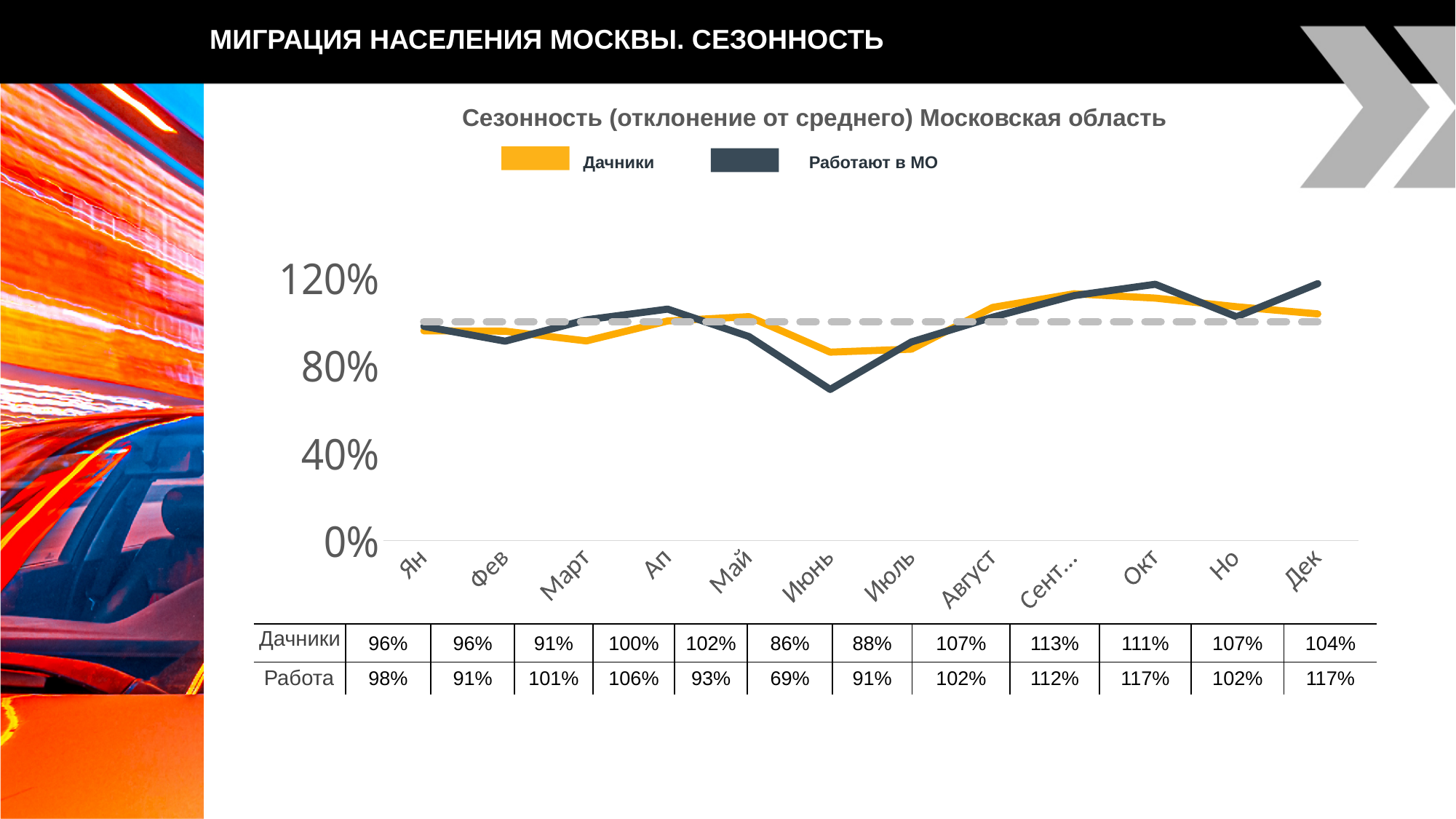
What is the value for Работа in Окт? 117% What is the value for Дачники in Июнь? 86% What is the difference between the Дачники and Работа values in Июнь? 17 percentage points How many months are plotted along the x axis? 12 Do the Дачники values rise or fall from Июнь to Сент...? rise How many series does the legend list? 2 In Май, which series has the larger value, Дачники or Работа? Дачники In which month is the Работа series at its lowest? Июнь In which month does the Работа series reach its highest value of 117% for the first time? Окт What is the title of the chart? Сезонность (отклонение от среднего) Московская область What kind of chart is shown on the slide? line chart Is the value for Работа in Июнь greater or less than 80%? less